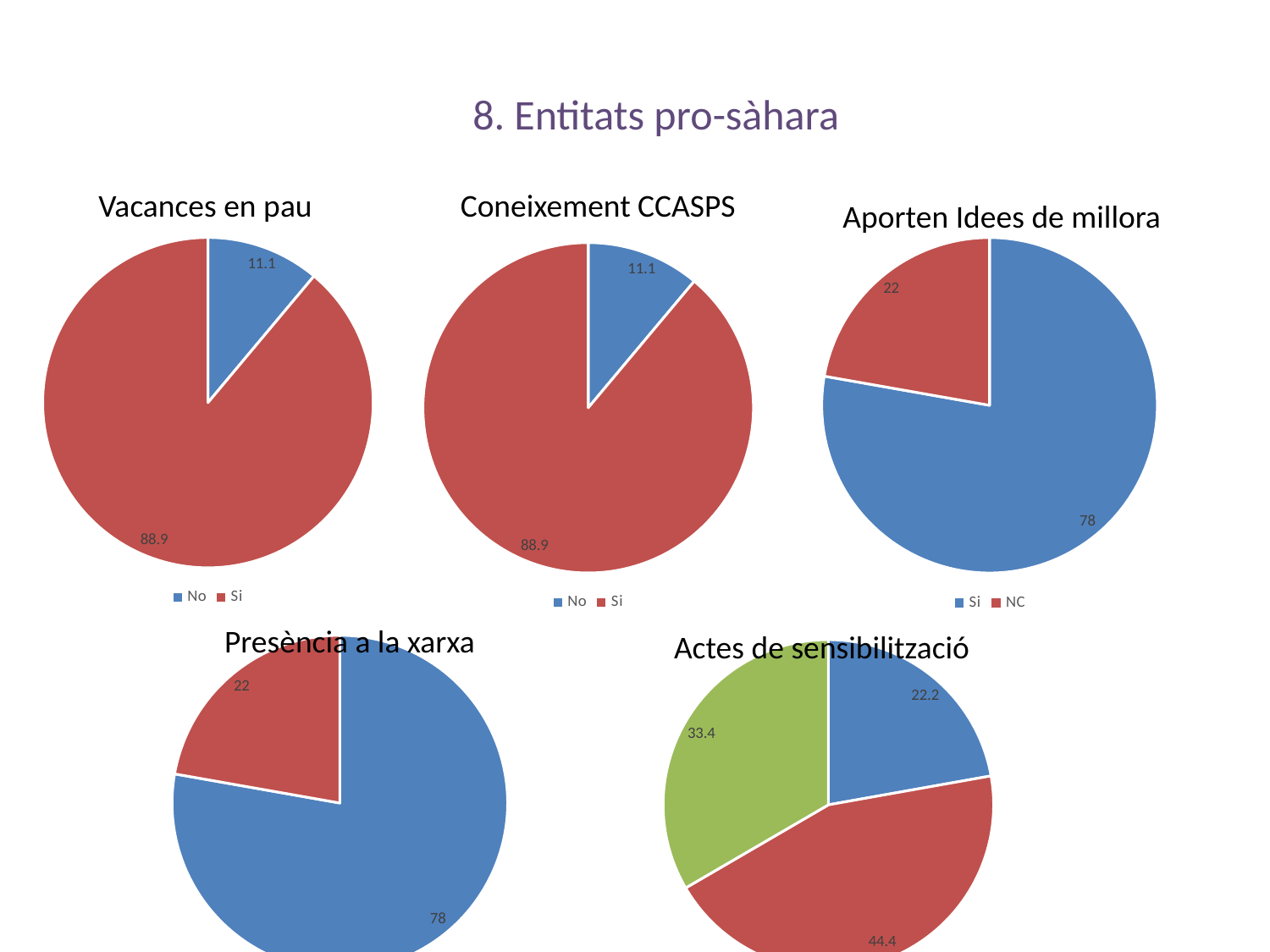
What type of chart is 'Presència a la xarxa'? Pie chart In the 'Coneixement CCASPS' chart, what is the value for No? 11.1 In the 'Vacances en pau' chart, what is the value for No? 11.1 In the 'Aporten Idees de millora' chart, which category is the largest? Si In the 'Aporten Idees de millora' chart, which is larger, Si or NC? Si How many slices does the 'Actes de sensibilització' chart have? 3 In the 'Vacances en pau' chart, what is the value for Si? 88.9 In the 'Coneixement CCASPS' chart, which category is the smallest? No In the 'Aporten Idees de millora' chart, what is the value for NC? 22 In the 'Aporten Idees de millora' chart, what is the value for Si? 78 In the 'Vacances en pau' chart, what is the difference between the Si and No values? 77.8 How many entries does the legend of the 'Aporten Idees de millora' chart list? 2